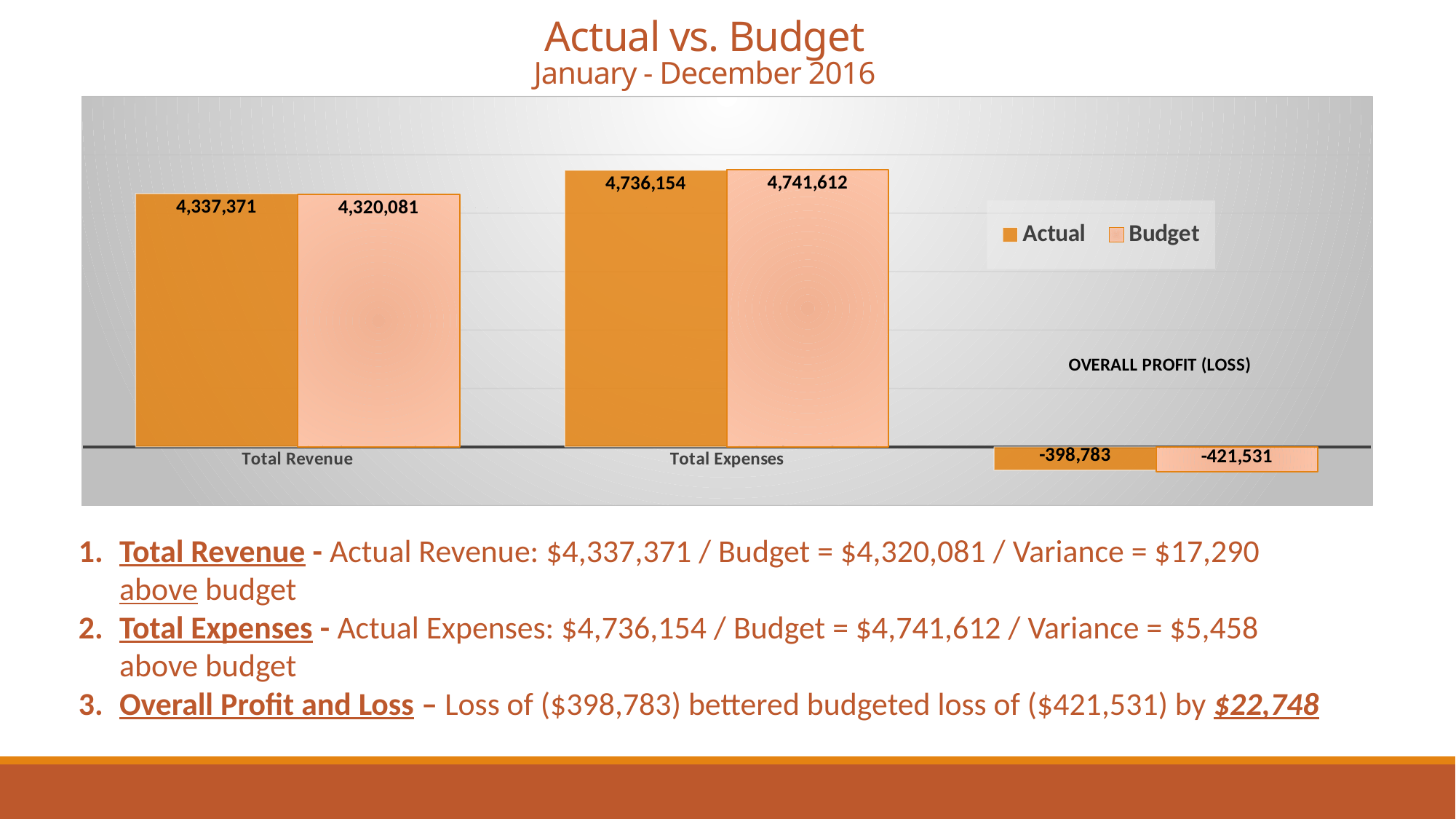
For Total Revenue, which is larger: the Actual value or the Budget value? Actual What kind of chart is shown on the slide? Bar chart What is the difference between the Actual and Budget values for Total Revenue? 17,290 Which category has the lowest Budget value? Overall Profit (Loss) What is the Budget value for Overall Profit (Loss)? -421,531 What is the difference between the Budget and Actual values for Total Expenses? 5,458 What is the Actual value for Overall Profit (Loss)? -398,783 What is the Actual value for Total Revenue? 4,337,371 What is the Budget value for Total Expenses? 4,741,612 Which category has the highest Actual value? Total Expenses How many categories are shown on the x axis of the chart? 3 How many series does the chart legend list? 2